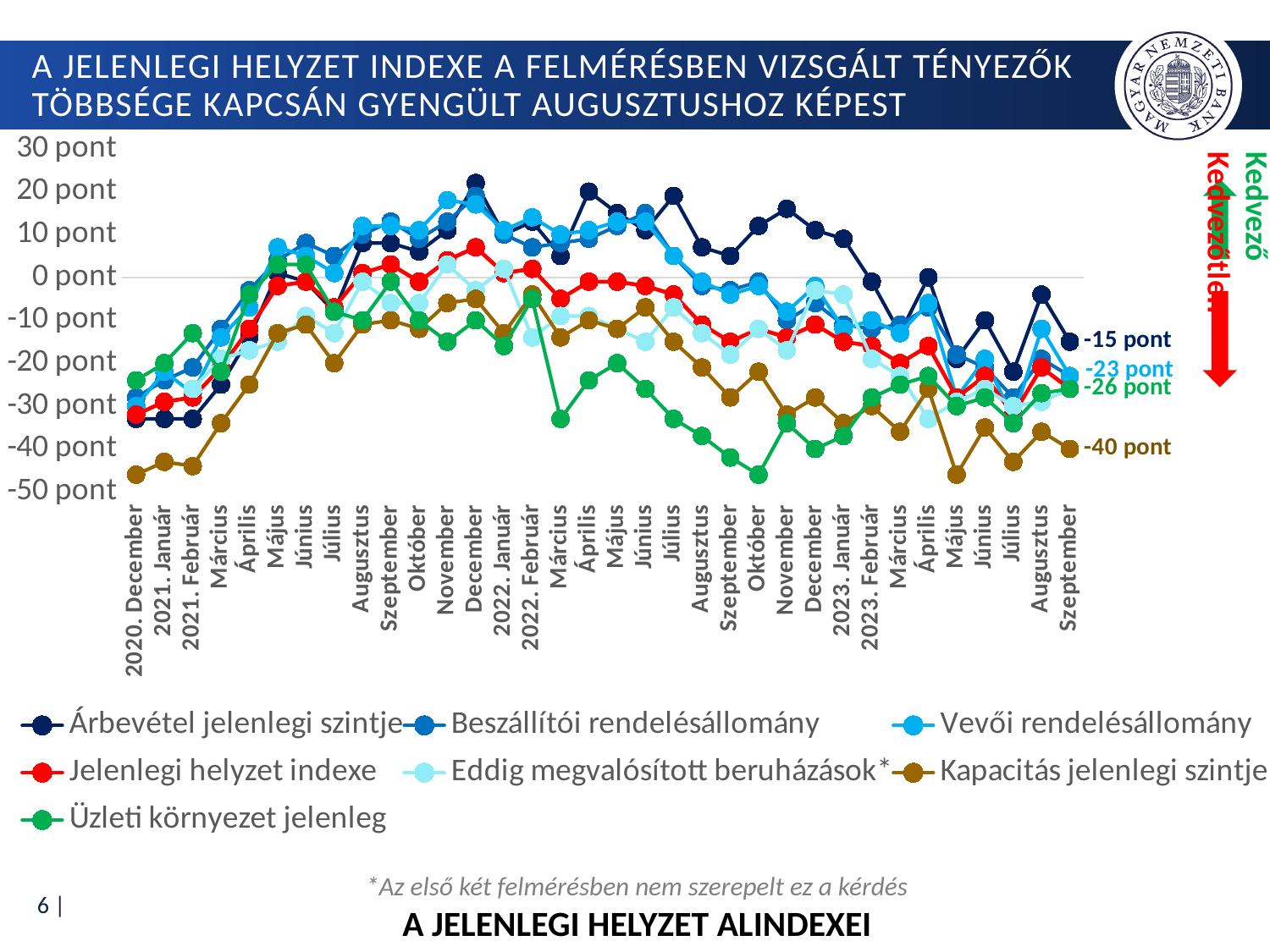
Which series has the highest value at 2023 Szeptember? Árbevétel jelenlegi szintje What is the value of Üzleti környezet jelenleg at 2023 Szeptember? -26 pont Is the value of Kapacitás jelenlegi szintje at 2020 December greater or less than -40 pont? less What kind of chart is shown on the slide? line chart What is the difference between Árbevétel jelenlegi szintje (-15 pont) and Kapacitás jelenlegi szintje (-40 pont) at 2023 Szeptember? 25 pont How many series does the legend list? 7 Which series has the lowest value at 2023 Szeptember? Kapacitás jelenlegi szintje What is the value of Árbevétel jelenlegi szintje at 2023 Szeptember? -15 pont Does Kapacitás jelenlegi szintje rise or fall from 2020 December to 2021 Június? rise What is the value of Kapacitás jelenlegi szintje at 2023 Szeptember? -40 pont How many monthly points are shown along the x axis? 34 Is the value of Árbevétel jelenlegi szintje at 2021 December greater or less than 20 pont? greater